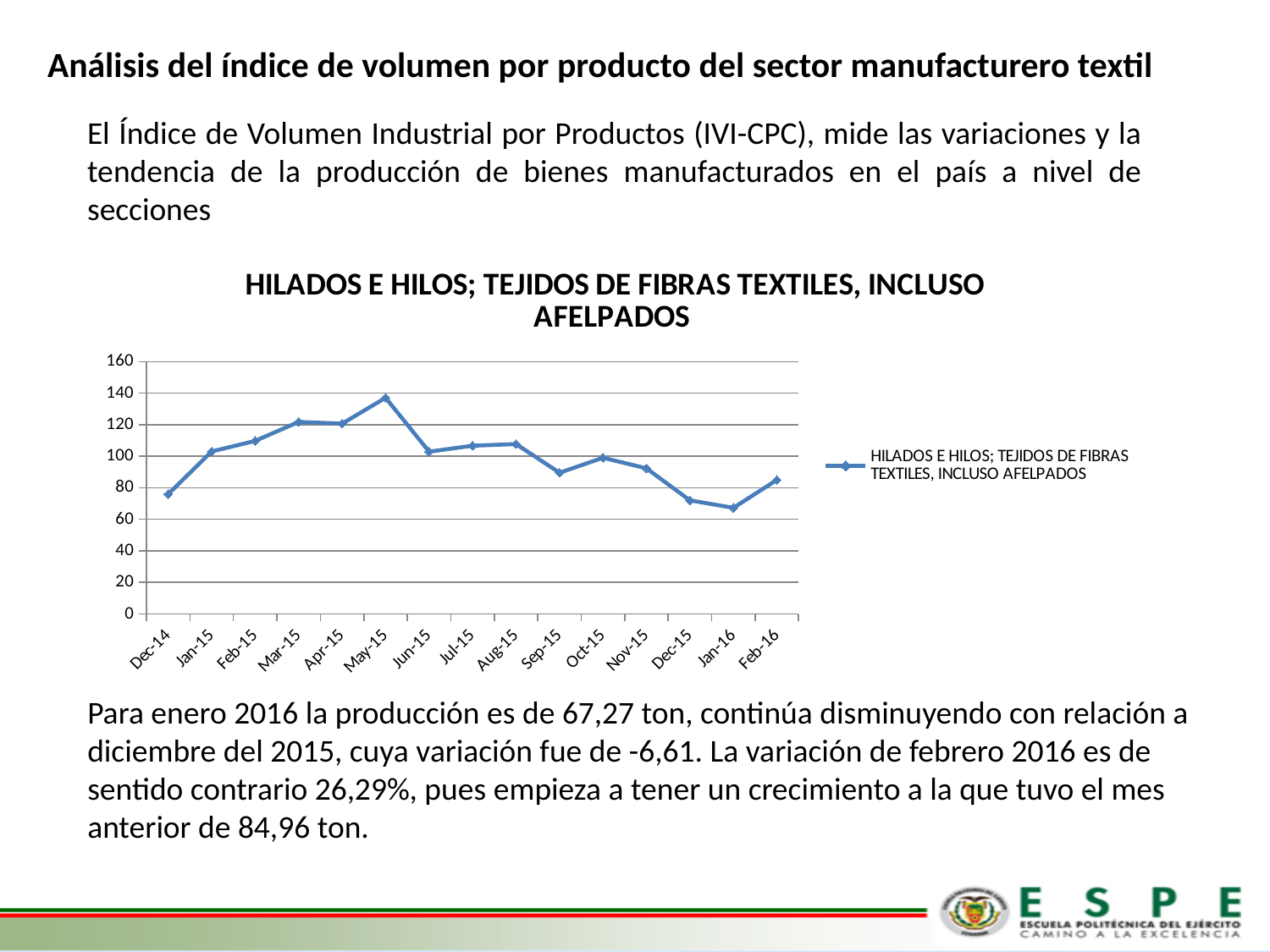
Is the value for Jan-16 greater or less than 80? less Which month has the lowest value on the chart? Jan-16 How many series does the legend list? 1 Which is larger, the value for Mar-15 or the value for Sep-15? Mar-15 Is the value for Sep-15 greater or less than 100? less Do the values rise or fall from May-15 to Jan-16? fall Which month has the highest value on the chart? May-15 Is the value for Dec-14 greater or less than 80? less How many data points are plotted on the line chart? 15 What kind of chart is shown on the slide? line chart What is the title of the chart? HILADOS E HILOS; TEJIDOS DE FIBRAS TEXTILES, INCLUSO AFELPADOS